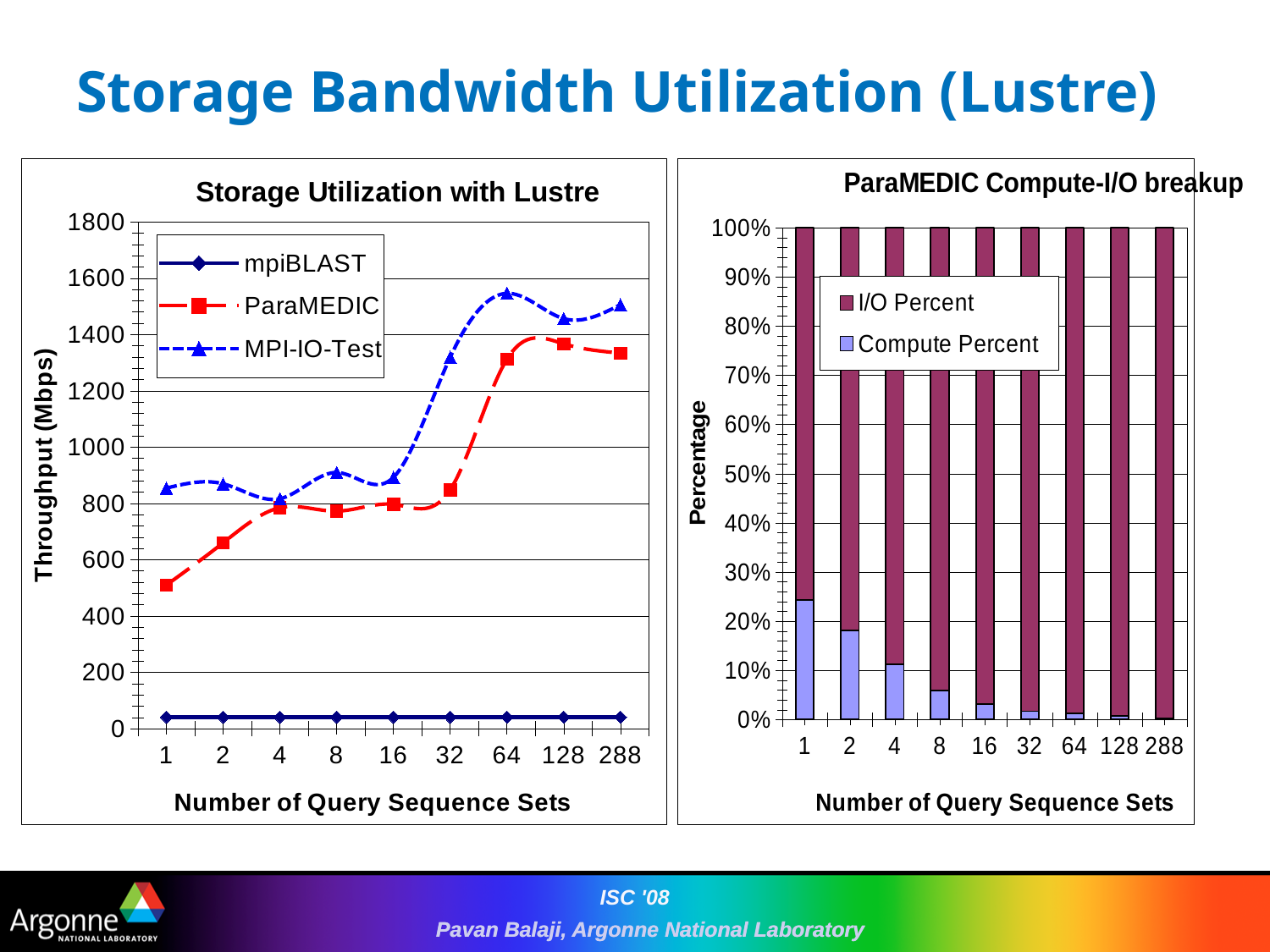
In the 'Storage Utilization with Lustre' chart, how many series does the legend list? 3 In the 'ParaMEDIC Compute-I/O breakup' chart, is the Compute Percent at 1 query sequence set greater or less than 20%? greater What is the y-axis label of the 'Storage Utilization with Lustre' chart? Throughput (Mbps) In the 'Storage Utilization with Lustre' chart, is the ParaMEDIC throughput at 1 query sequence set greater or less than 400? greater In the 'ParaMEDIC Compute-I/O breakup' chart, does the Compute Percent rise or fall as the number of query sequence sets increases? fall In the 'Storage Utilization with Lustre' chart, is the mpiBLAST throughput at 288 query sequence sets greater or less than 200? less In the 'Storage Utilization with Lustre' chart, which series has the higher throughput at 32 query sequence sets, ParaMEDIC or MPI-IO-Test? MPI-IO-Test In the 'Storage Utilization with Lustre' chart, which series has the lowest throughput across all query sequence set counts? mpiBLAST In the 'ParaMEDIC Compute-I/O breakup' chart, how many categories are shown on the x axis? 9 What kind of chart is the 'ParaMEDIC Compute-I/O breakup' chart on the right? stacked bar chart What kind of chart is the 'Storage Utilization with Lustre' chart on the left? line chart